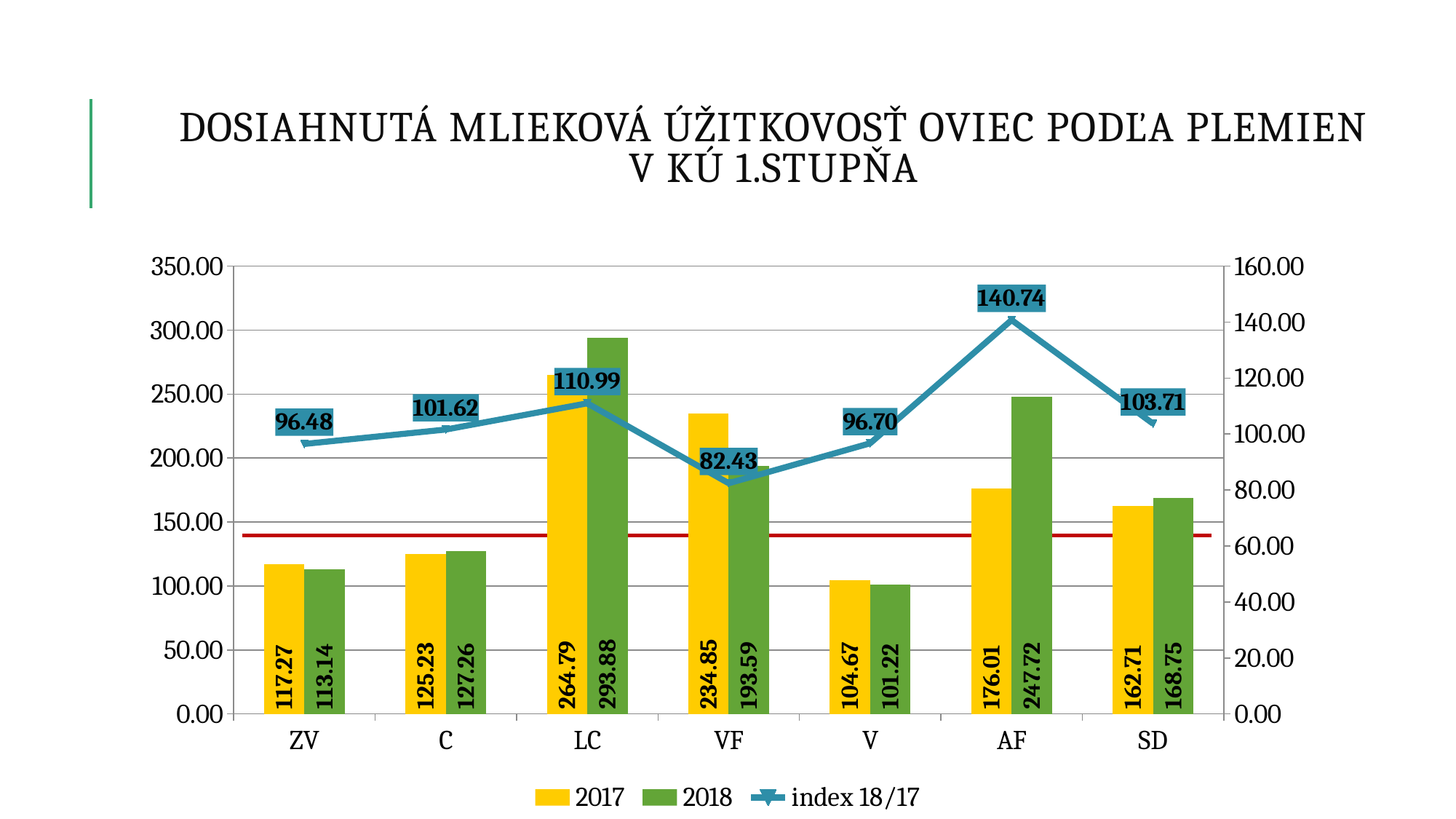
What is the difference between the 2018 and 2017 values for AF? 71.71 Which category has the highest index 18/17 value? AF Which category has the lowest 2017 value? V What is the 2018 value for AF? 247.72 What is the 2017 value for LC? 264.79 Which is larger for VF, the 2017 value or the 2018 value? 2017 What kind of chart is this? Combined bar and line chart Which series is shown in green? 2018 How many series does the legend list? 3 Which category has the highest 2018 value? LC How many categories are shown on the x axis? 7 What is the index 18/17 value for VF? 82.43